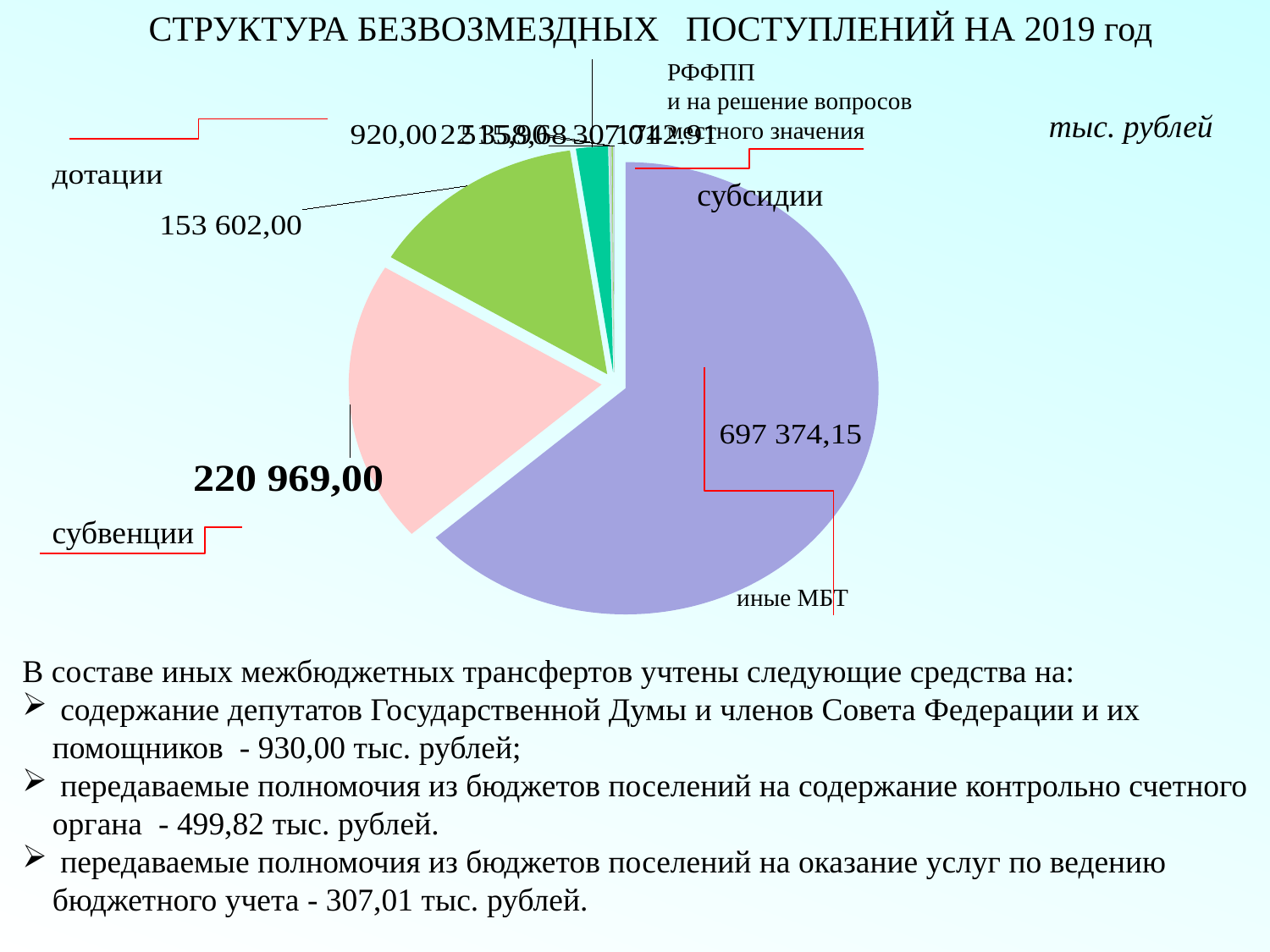
What is the difference between the values for субвенции and дотации? 67 367,00 What is the title of the chart? СТРУКТУРА БЕЗВОЗМЕЗДНЫХ ПОСТУПЛЕНИЙ НА 2019 год What is the value shown for дотации? 153 602,00 What kind of chart is shown on the slide? pie chart What is the value of the largest slice of the pie? 697 374,15 What is the difference between the largest slice (697 374,15) and субвенции? 476 405,15 What is the value shown for субвенции? 220 969,00 In what units are the values on the chart given? тыс. рублей Is the value for дотации greater or less than 200 000? less Which is larger, субвенции or дотации? субвенции